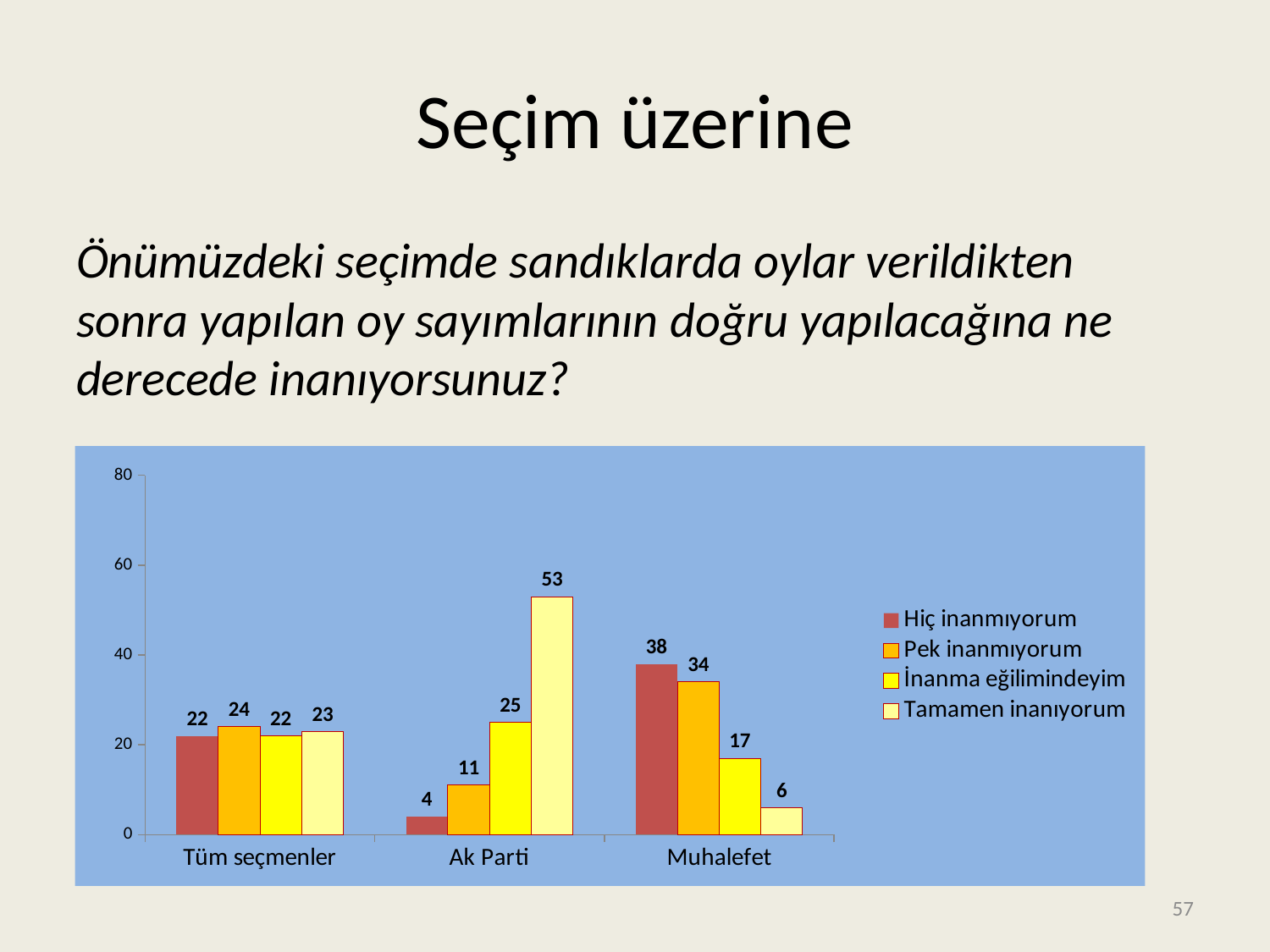
What is the value for "Hiç inanmıyorum" in the Muhalefet category? 38 How many categories are shown on the x axis? 3 What is the difference between the "Tamamen inanıyorum" values for Ak Parti and Muhalefet? 47 What kind of chart is shown on the slide? Bar chart How many series does the legend list? 4 Is the value for "Tamamen inanıyorum" in the Ak Parti category greater or less than 40? greater Which series has the highest value in the Muhalefet category? Hiç inanmıyorum Which is larger: "Pek inanmıyorum" for Muhalefet or "İnanma eğilimindeyim" for Ak Parti? Pek inanmıyorum for Muhalefet What is the value for "Tamamen inanıyorum" in the Ak Parti category? 53 What colour represents the "Pek inanmıyorum" series in the legend? Orange What is the value for "Pek inanmıyorum" in the Tüm seçmenler category? 24 Which series has the lowest value in the Ak Parti category? Hiç inanmıyorum